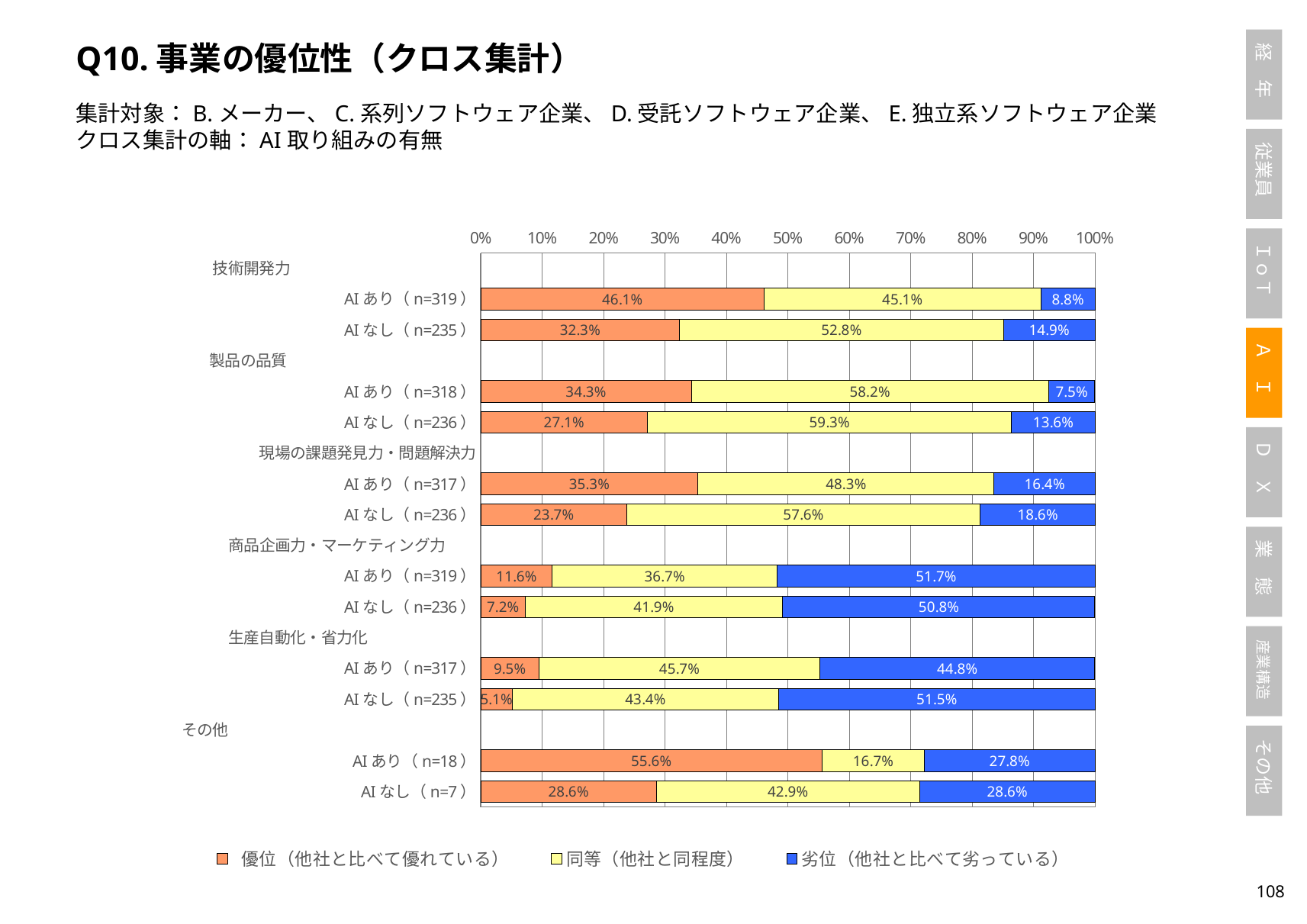
What is the difference between the 劣位 values for 生産自動化・省力化 AI なし (n=235) and AI あり (n=317)? 6.7% Which bar has the highest 同等 (equal) value? 製品の品質, AI なし (n=236) What is the difference between the 優位 values for 技術開発力 AI あり (n=319) and AI なし (n=235)? 13.8% Which bar has the lowest 優位 (superior) value? 生産自動化・省力化, AI なし (n=235) What is the 劣位 (inferior) value for 商品企画力・マーケティング力, AI あり (n=319)? 51.7% Which is larger: the 劣位 value for 現場の課題発見力・問題解決力 AI あり (n=317) or AI なし (n=236)? AI なし (n=236) What is the 同等 (equal) value for 製品の品質, AI なし (n=236)? 59.3% What colour represents the 劣位 (inferior) series? Blue What is the 優位 (superior) value for 技術開発力, AI あり (n=319)? 46.1% What is the 優位 value for その他, AI あり (n=18)? 55.6% How many series does the legend list? 3 What type of chart is shown on the slide? Stacked bar chart